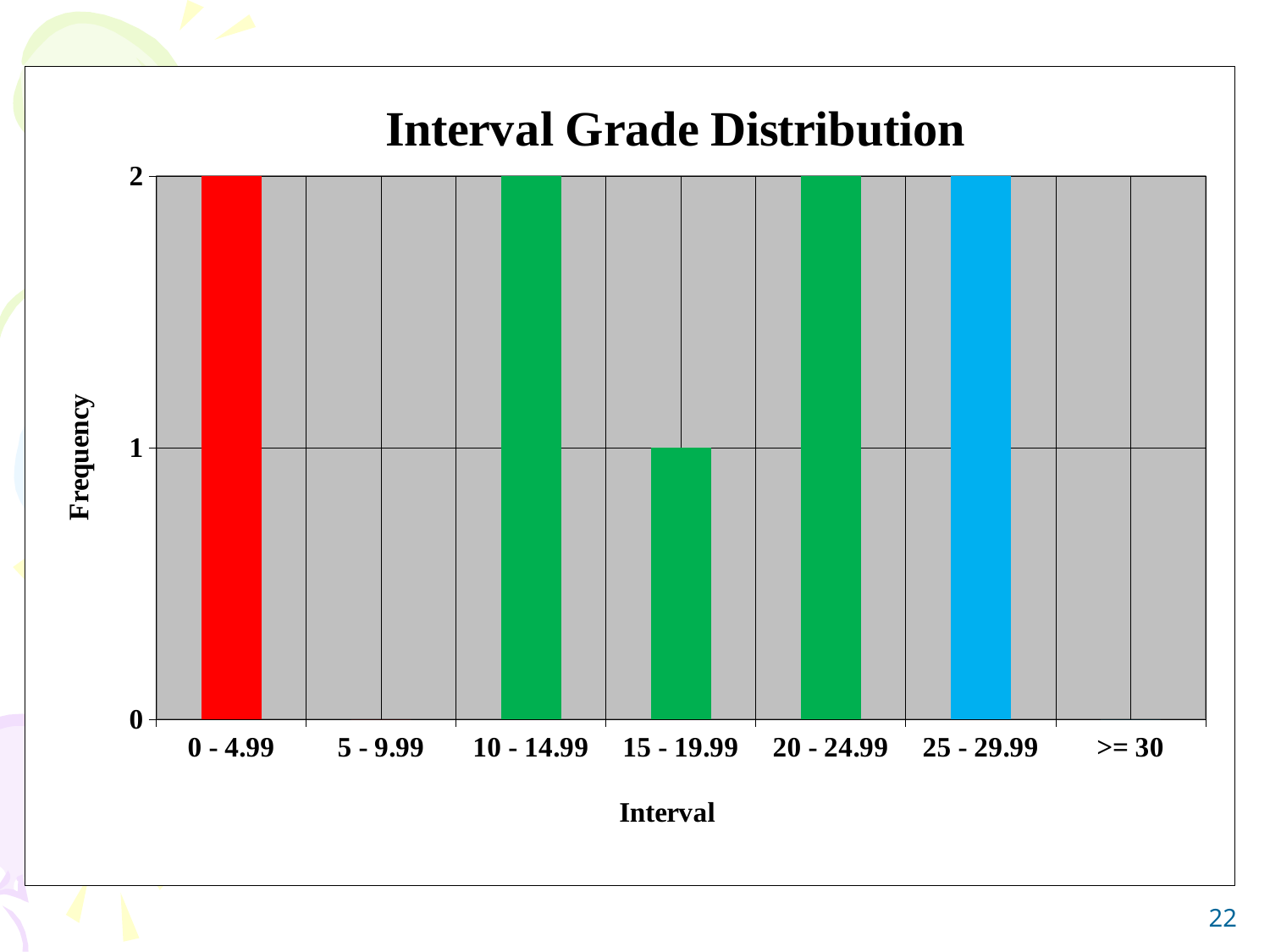
Which has a higher frequency, the interval 10 - 14.99 or the interval 15 - 19.99? 10 - 14.99 What is the frequency for the interval 25 - 29.99? 2 What is the frequency for the interval 5 - 9.99? 0 Which interval is shown with a red bar? 0 - 4.99 What is the difference in frequency between the interval 20 - 24.99 and the interval 15 - 19.99? 1 What is the frequency for the interval 15 - 19.99? 1 How many intervals are shown on the x axis? 7 What is the title of the chart? Interval Grade Distribution What is the frequency for the interval 0 - 4.99? 2 What is the frequency for the interval >= 30? 0 What kind of chart is shown on the slide? Bar chart